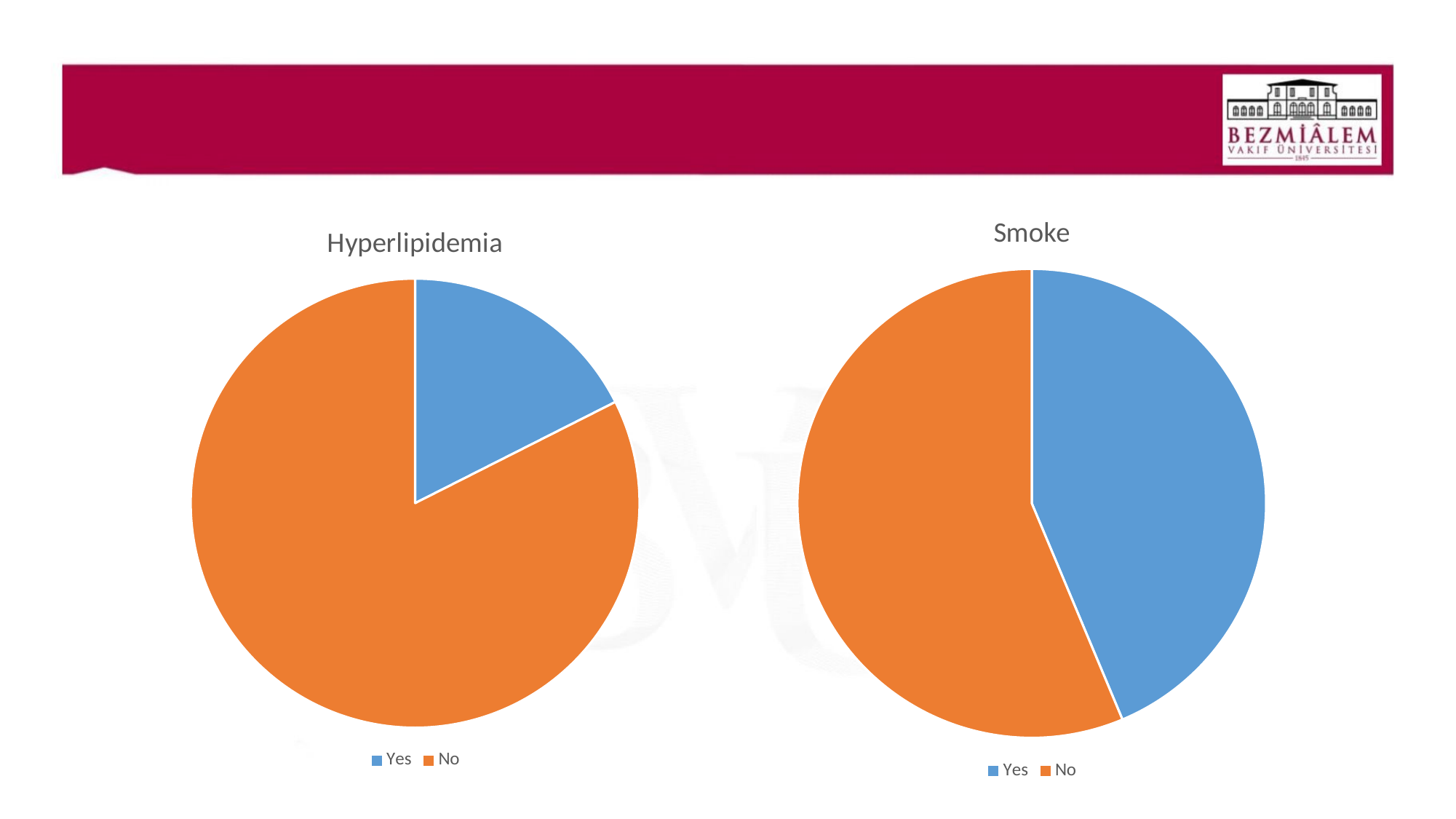
In the Hyperlipidemia chart, is the slice for Yes or the slice for No larger? No In the Smoke chart, which category has the smallest slice? Yes In the Hyperlipidemia chart, which category has the smallest slice? Yes What is the title of the pie chart on the left of the slide? Hyperlipidemia How many entries does the legend of the Smoke chart list? 2 How many slices does the Hyperlipidemia pie chart have? 2 In the Smoke chart, is the slice for Yes or the slice for No larger? No In the Hyperlipidemia chart, which category has the largest slice? No What kind of chart is the Hyperlipidemia chart? pie chart What kind of chart is the Smoke chart? pie chart In the Smoke chart, which category has the largest slice? No In the Smoke chart, what colour is the Yes slice? blue